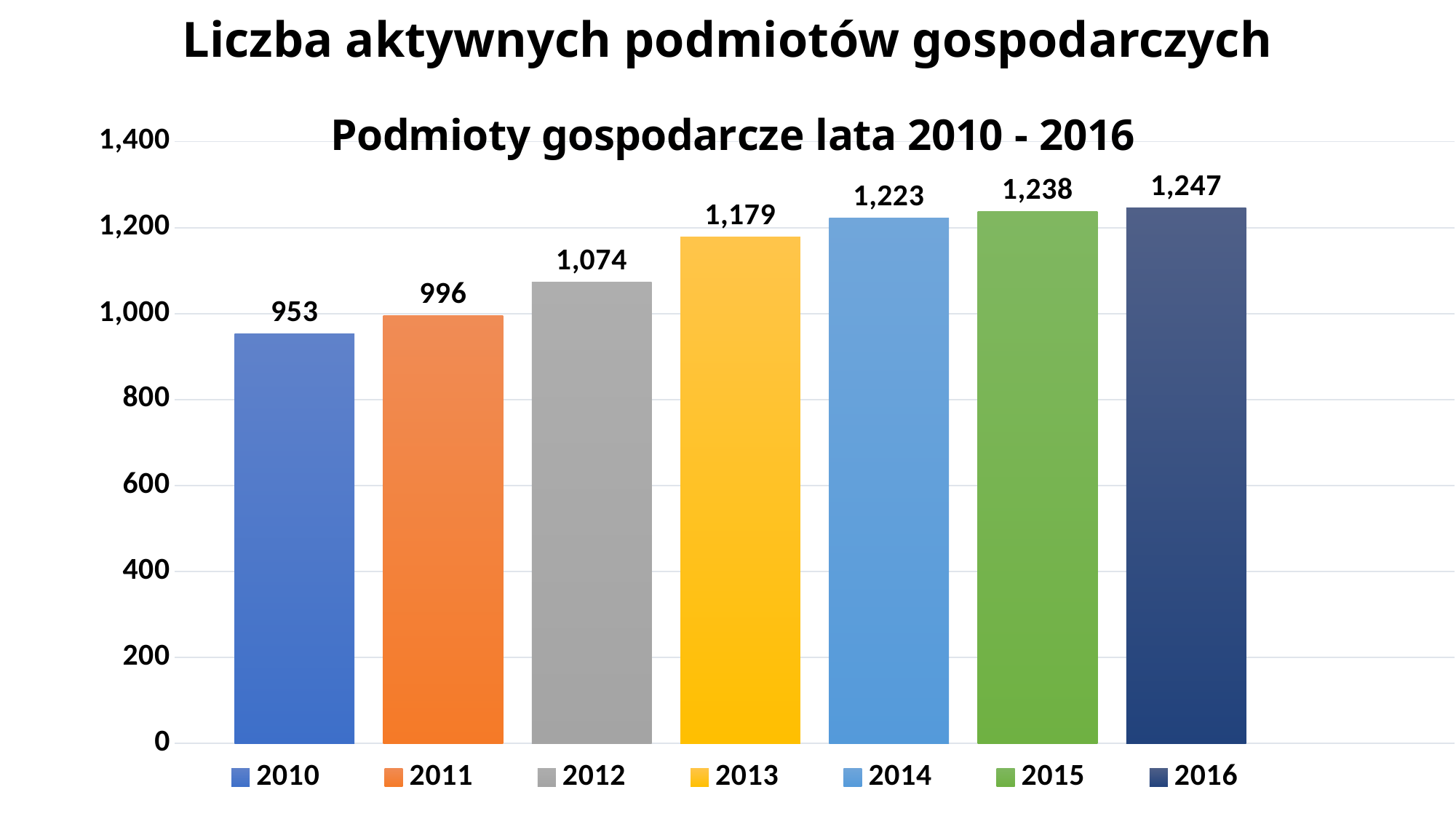
What is the difference between the values for 2012 and 2011? 78 Which year has the highest value? 2016 How many years are shown in the chart? 7 Which year has the lowest value? 2010 Which is larger, the value for 2012 or the value for 2014? 2014 What is the difference between the values for 2016 and 2010? 294 What is the value for 2010? 953 What is the value for 2013? 1,179 Do the values rise or fall from 2010 to 2016? rise Is the value for 2011 greater or less than 1,000? less What is the value for 2016? 1,247 What kind of chart is shown on the slide? bar chart